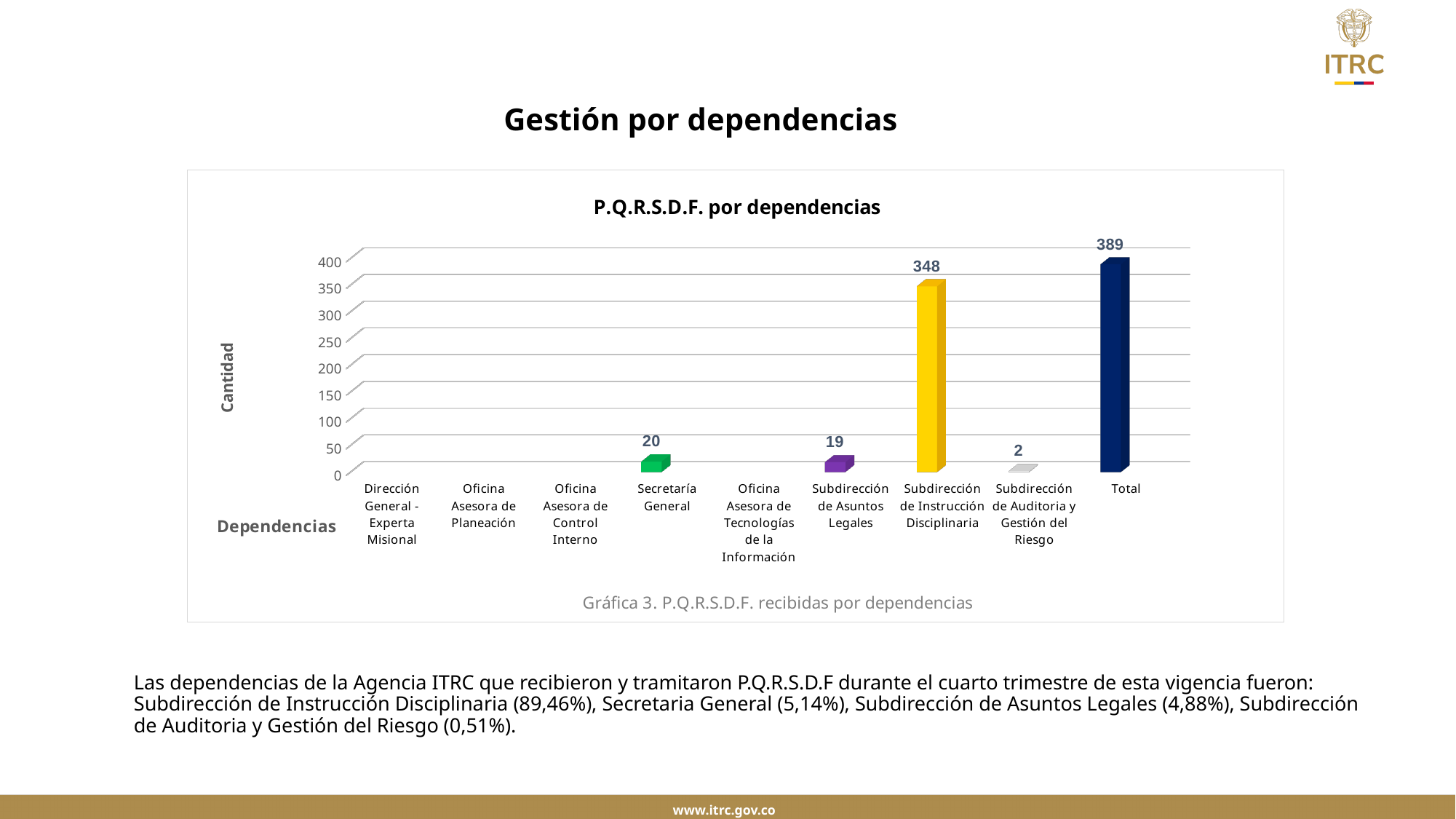
What is the value shown for Total in the chart? 389 What is the value for Subdirección de Instrucción Disciplinaria in the P.Q.R.S.D.F. por dependencias chart? 348 What kind of chart is shown on the slide? Bar chart What is the difference between the values for Subdirección de Instrucción Disciplinaria and Secretaría General? 328 How many categories are shown on the x axis of the chart? 9 Which is larger, the value for Secretaría General or the value for Subdirección de Asuntos Legales? Secretaría General What is the value for Subdirección de Auditoria y Gestión del Riesgo in the chart? 2 What is the value for Secretaría General in the chart? 20 Excluding the Total bar, which dependencia has the highest value in the chart? Subdirección de Instrucción Disciplinaria What is the value for Subdirección de Asuntos Legales in the chart? 19 Is the value for Subdirección de Instrucción Disciplinaria greater or less than 300? greater What is the difference between the Total value and the value for Subdirección de Instrucción Disciplinaria? 41